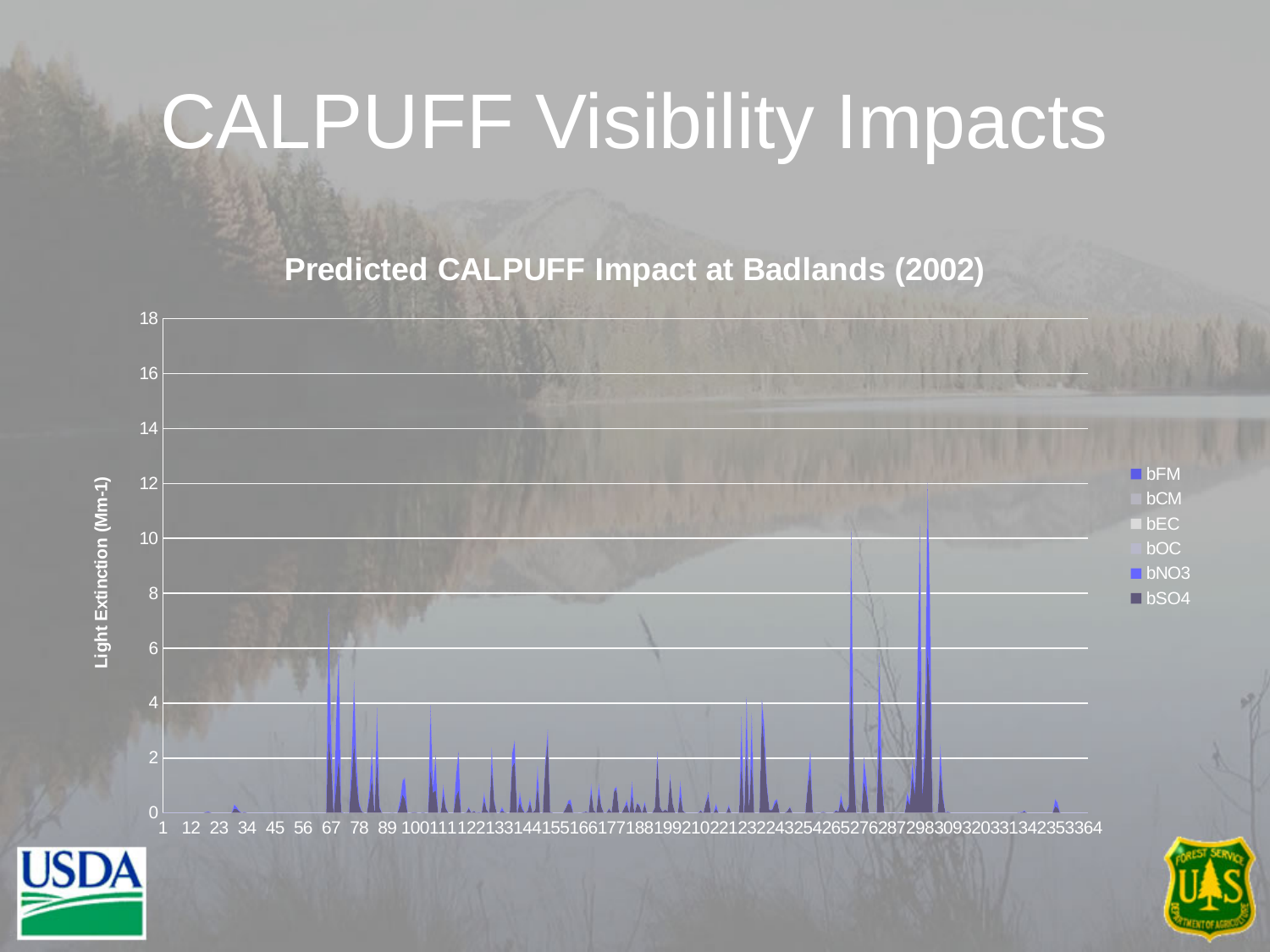
What is the last label on the horizontal axis? 364 Is the highest peak on the chart (near day 298) greater or less than 14? less How many series does the legend list? 6 Is the peak near day 265 greater or less than 8? greater What kind of chart is shown on the slide? stacked area chart Is the peak near day 67 greater or less than 8? less Is the peak near day 298 larger or smaller than the peak near day 67? larger What is the maximum value shown on the vertical axis? 18 What is the label of the vertical axis? Light Extinction (Mm-1) What is the title of the chart? Predicted CALPUFF Impact at Badlands (2002)